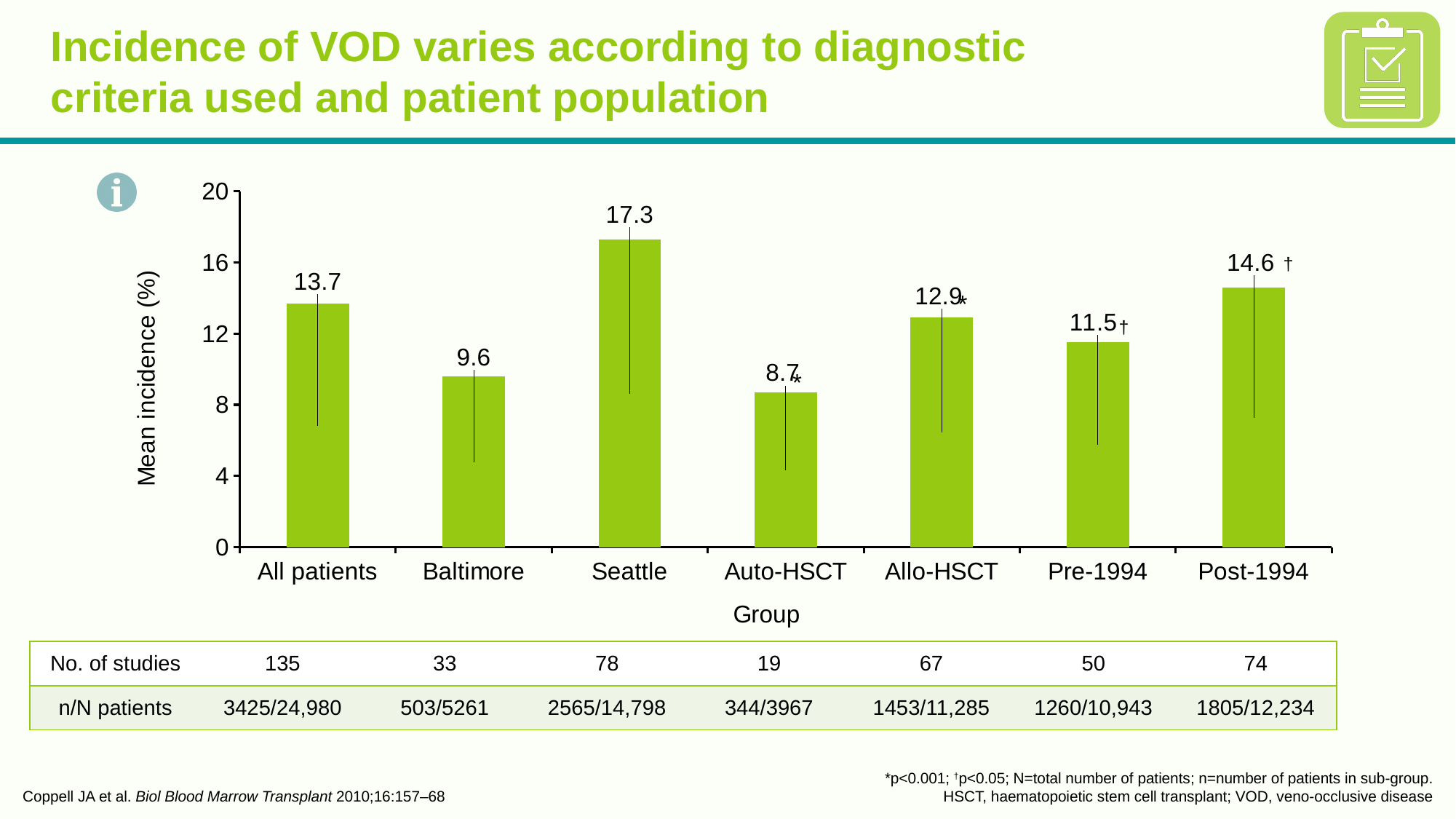
What is the label of the y axis? Mean incidence (%) What is the mean incidence (%) for the Seattle group? 17.3 What is the mean incidence (%) for the Post-1994 group? 14.6 What is the label of the x axis? Group What is the difference in mean incidence between the Seattle and Baltimore groups? 7.7 What is the mean incidence (%) for the Auto-HSCT group? 8.7 Which group has the lowest mean incidence? Auto-HSCT Which group has a higher mean incidence, Allo-HSCT or Pre-1994? Allo-HSCT Is the mean incidence for All patients greater or less than 12? greater Which group has the highest mean incidence? Seattle How many groups are shown on the x axis of the chart? 7 What kind of chart is shown on the slide? Bar chart